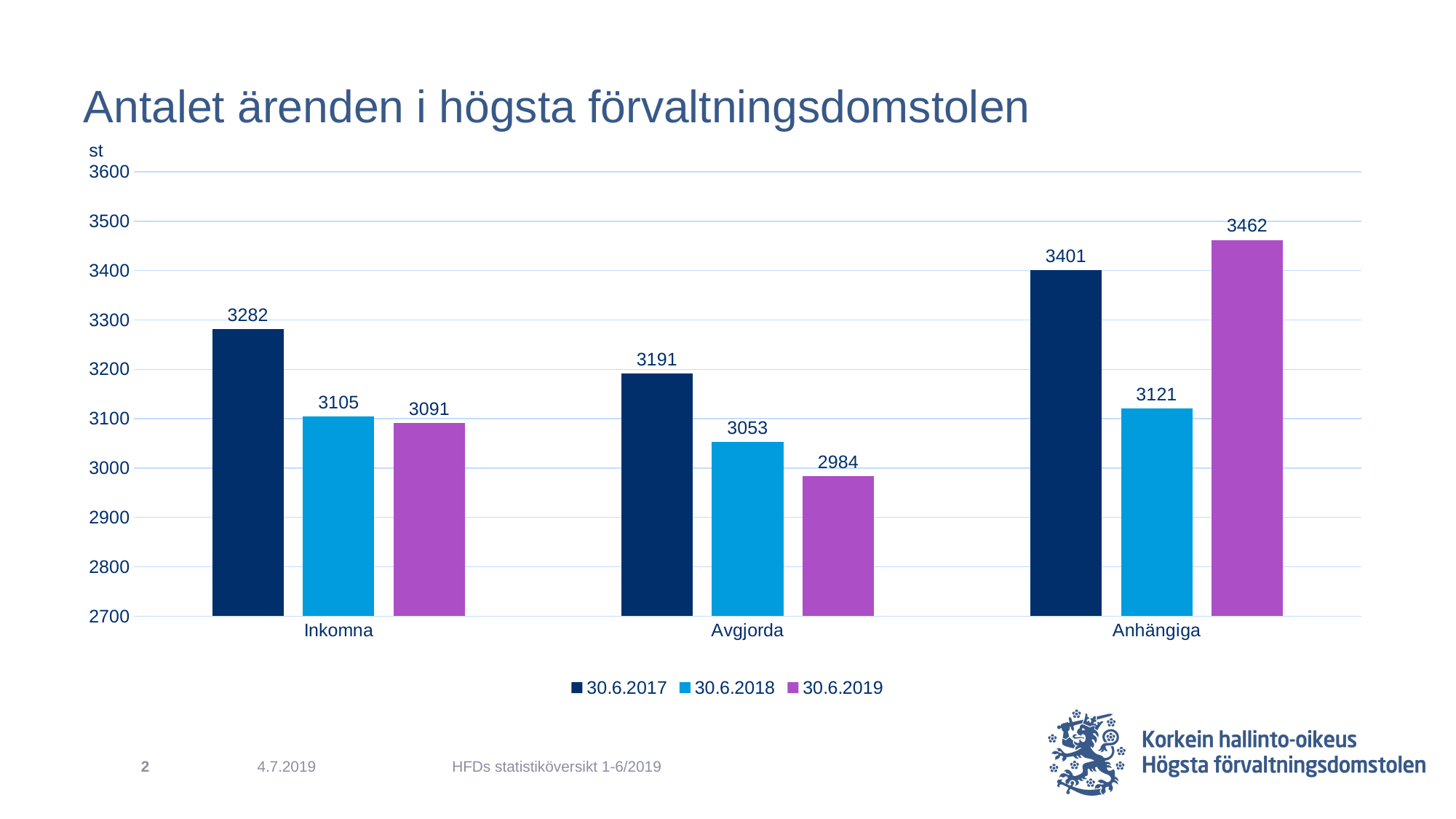
What is the value for Inkomna in the 30.6.2017 series? 3282 What is the difference between the 30.6.2019 and 30.6.2017 values for Anhängiga? 61 How many series does the legend list? 3 Is the value for Anhängiga in the 30.6.2019 series greater or less than 3400? greater Which category has the lowest value in the 30.6.2018 series? Avgjorda What is the difference between the 30.6.2017 and 30.6.2018 values for Inkomna? 177 How many categories are shown on the x axis? 3 Which category has the highest value in the 30.6.2019 series? Anhängiga What kind of chart is shown on the slide? bar chart What is the value for Anhängiga in the 30.6.2018 series? 3121 What is the value for Avgjorda in the 30.6.2019 series? 2984 Which is larger for Avgjorda: the 30.6.2017 value or the 30.6.2018 value? 30.6.2017